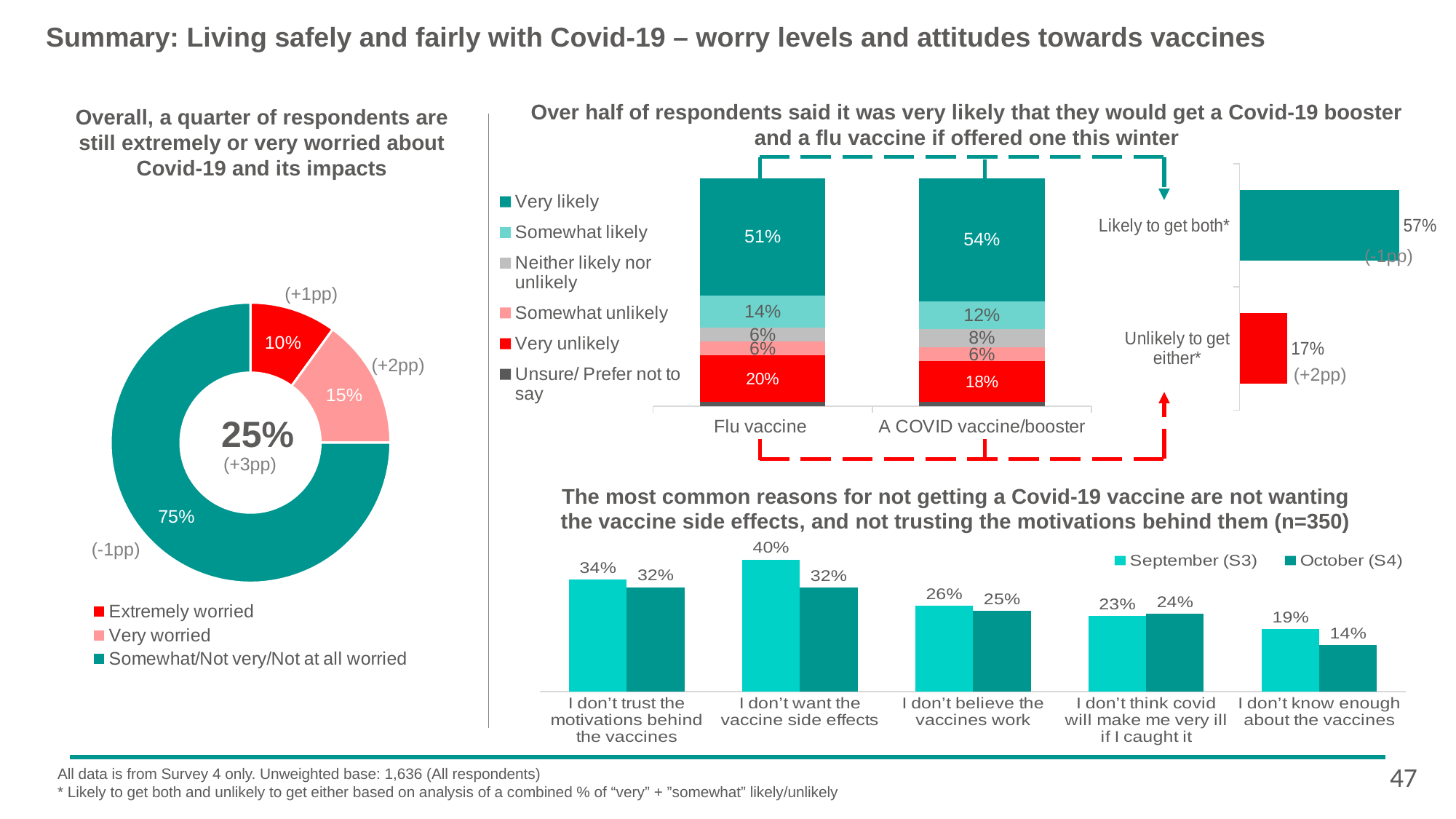
In the stacked bar chart about getting a Covid-19 booster and flu vaccine, what is the difference between the 'Very unlikely' values for the flu vaccine and the COVID vaccine/booster? 2 percentage points In the doughnut chart on the left, what percentage of respondents are 'Extremely worried'? 10% In the small horizontal bar chart on the right, what is the value for 'Likely to get both*'? 57% In the bottom chart about reasons for not getting a Covid-19 vaccine, which reason has the lowest October (S4) value? I don't know enough about the vaccines What kind of chart is the worry-levels chart on the left of the slide? Doughnut chart In the stacked bar chart about getting a Covid-19 booster and flu vaccine, what percentage said 'Very likely' for a COVID vaccine/booster? 54% In the bottom chart about reasons for not getting a Covid-19 vaccine, what is the difference between the September (S3) and October (S4) values for 'I don't know enough about the vaccines'? 5 percentage points How many reasons (categories) are shown in the bottom chart about reasons for not getting a Covid-19 vaccine? 5 How many series does the legend of the stacked bar chart about getting a Covid-19 booster and flu vaccine list? 6 In the bottom chart about reasons for not getting a Covid-19 vaccine, which reason has the highest September (S3) value? I don't want the vaccine side effects In the stacked bar chart about getting a Covid-19 booster and flu vaccine, which has the larger 'Somewhat likely' value: Flu vaccine or A COVID vaccine/booster? Flu vaccine In the bottom chart about reasons for not getting a Covid-19 vaccine, what is the October (S4) value for 'I don't want the vaccine side effects'? 32%